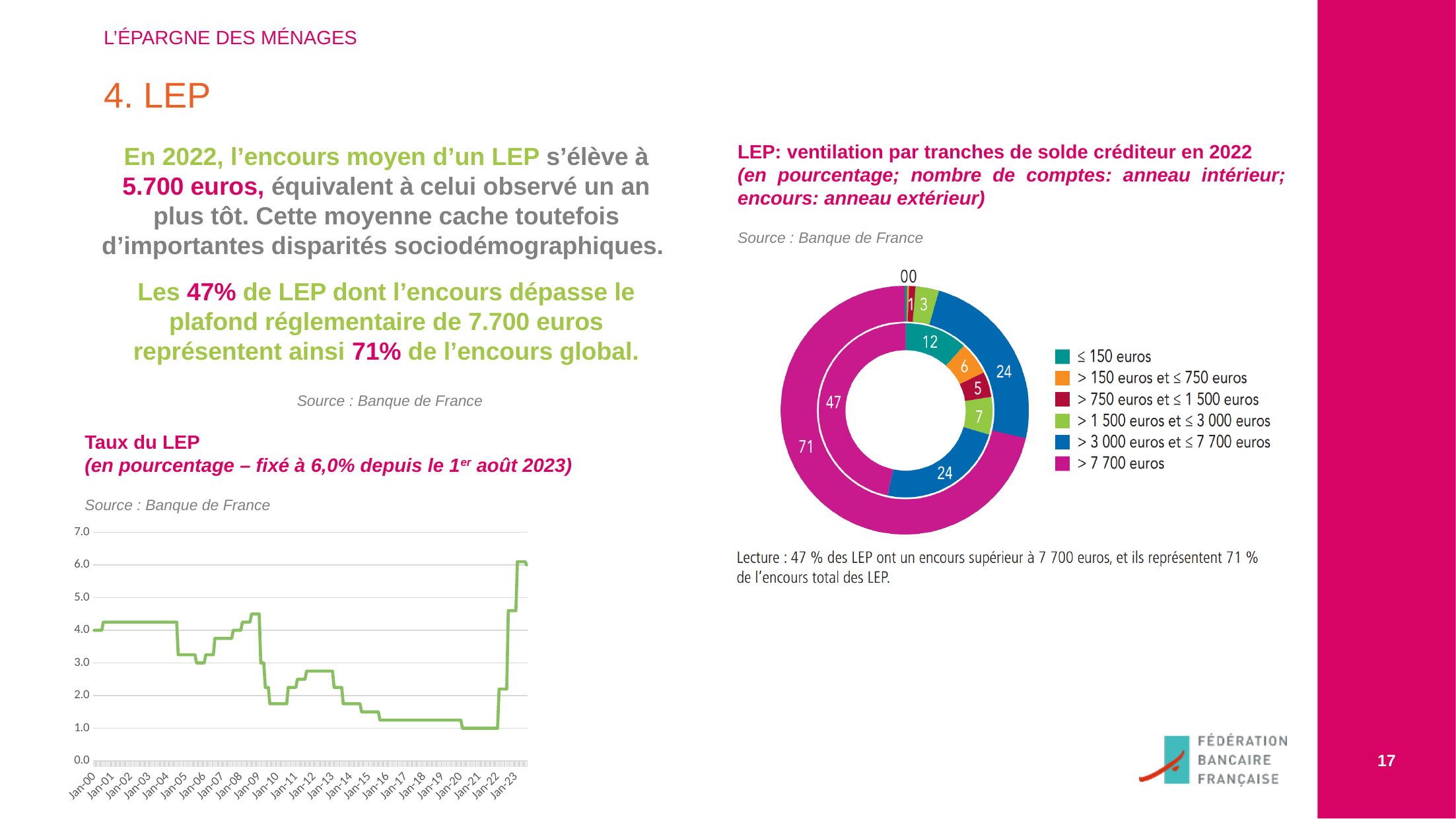
What kind of chart is the 'Taux du LEP' chart? line chart In the 'LEP: ventilation par tranches de solde créditeur en 2022' chart, which is larger in the inner ring: '> 150 euros et ≤ 750 euros' or '> 1 500 euros et ≤ 3 000 euros'? > 1 500 euros et ≤ 3 000 euros In the 'LEP: ventilation par tranches de solde créditeur en 2022' chart, what is the inner-ring (nombre de comptes) value for '> 7 700 euros'? 47 In the 'LEP: ventilation par tranches de solde créditeur en 2022' chart, what is the outer-ring (encours) value for '> 3 000 euros et ≤ 7 700 euros'? 24 In the 'LEP: ventilation par tranches de solde créditeur en 2022' chart, how many categories does the legend list? 6 In the 'LEP: ventilation par tranches de solde créditeur en 2022' chart, what is the outer-ring (encours) value for '> 7 700 euros'? 71 In the 'Taux du LEP' chart, is the value at Jan-21 greater or less than 2.0? less What kind of chart is the 'LEP: ventilation par tranches de solde créditeur en 2022' chart? donut chart In the 'LEP: ventilation par tranches de solde créditeur en 2022' chart, what is the inner-ring (nombre de comptes) value for '≤ 150 euros'? 12 In the 'LEP: ventilation par tranches de solde créditeur en 2022' chart, which category has the largest share of the inner ring (nombre de comptes)? > 7 700 euros In the 'LEP: ventilation par tranches de solde créditeur en 2022' chart, what is the difference between the outer-ring value and the inner-ring value for '> 7 700 euros'? 24